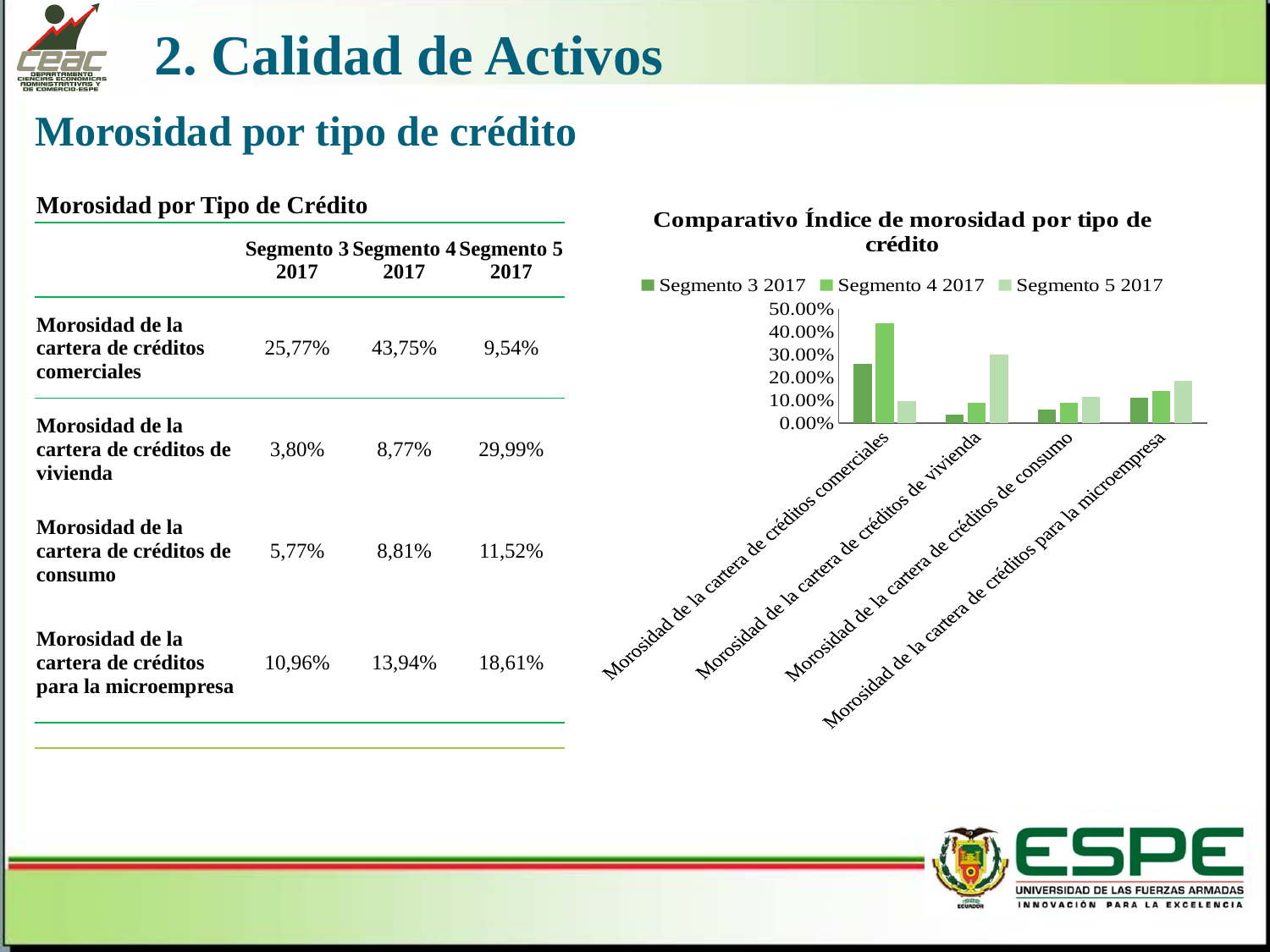
How many series does the legend of the bar chart list? 3 In the bar chart, is the Segmento 4 2017 value for "Morosidad de la cartera de créditos comerciales" greater or less than 40.00%? greater In the bar chart, is the Segmento 3 2017 value for "Morosidad de la cartera de créditos de vivienda" greater or less than 10.00%? less In the bar chart, is the Segmento 5 2017 value for "Morosidad de la cartera de créditos de vivienda" greater or less than 20.00%? greater In the bar chart, for "Morosidad de la cartera de créditos para la microempresa", which is larger: Segmento 3 2017 or Segmento 5 2017? Segmento 5 2017 How many credit-type categories are shown on the x axis of the bar chart? 4 What is the title of the bar chart on the slide? Comparativo Índice de morosidad por tipo de crédito In the bar chart, which series has the tallest bar for "Morosidad de la cartera de créditos comerciales"? Segmento 4 2017 According to the table on the slide, what is the Segmento 4 2017 value for "Morosidad de la cartera de créditos comerciales"? 43,75% According to the table on the slide, what is the Segmento 5 2017 value for "Morosidad de la cartera de créditos de vivienda"? 29,99% In the bar chart, which series has the shortest bar for "Morosidad de la cartera de créditos comerciales"? Segmento 5 2017 What kind of chart is the "Comparativo Índice de morosidad por tipo de crédito" chart? bar chart